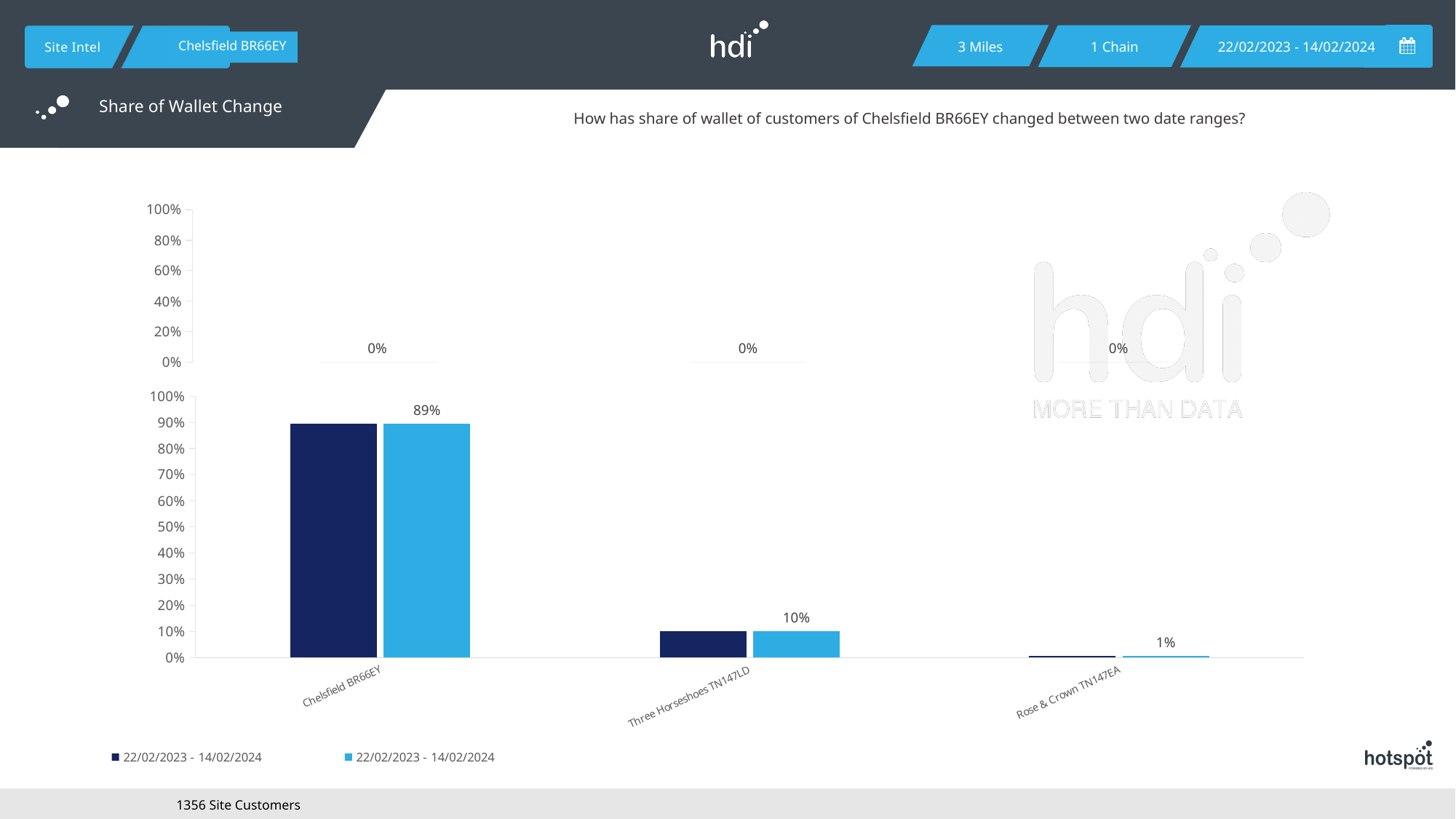
What is the difference between the labelled share of wallet for Chelsfield BR66EY and Three Horseshoes TN147LD? 79 percentage points What change value is shown for Chelsfield BR66EY in the upper panel of the chart? 0% What is the share of wallet value labelled for Rose & Crown TN147EA in the lower chart? 1% Which has the larger share of wallet, Three Horseshoes TN147LD or Rose & Crown TN147EA? Three Horseshoes TN147LD How many sites are shown on the x axis of the chart? 3 What kind of chart is shown on the slide? bar chart What is the share of wallet value labelled for Chelsfield BR66EY in the lower chart? 89% Which site has the highest share of wallet in the lower chart? Chelsfield BR66EY Which site has the lowest share of wallet in the lower chart? Rose & Crown TN147EA Is the dark blue bar for Chelsfield BR66EY in the lower chart greater or less than 80%? greater What is the share of wallet value labelled for Three Horseshoes TN147LD in the lower chart? 10% How many series does the legend list? 2